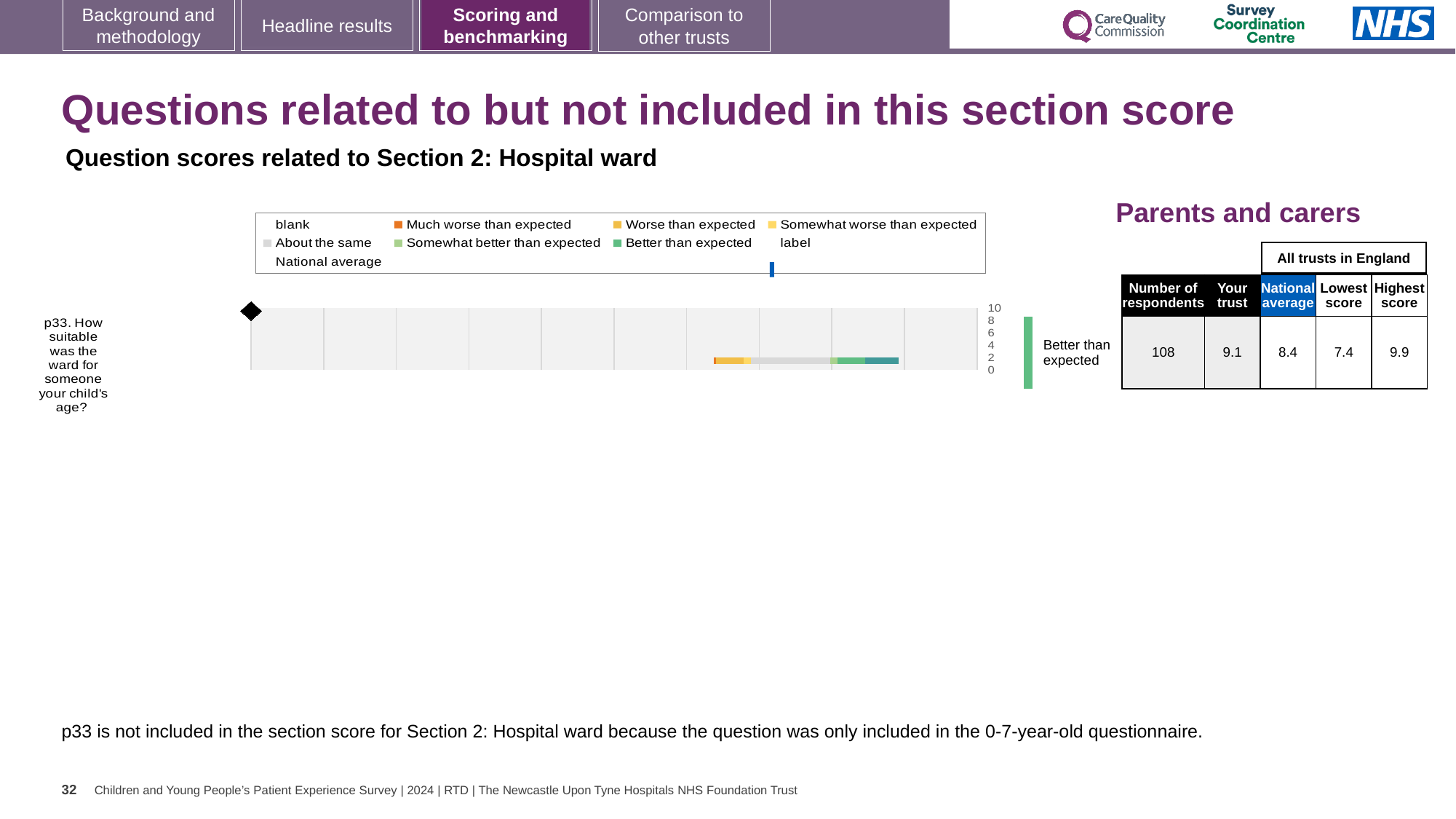
What is the highest score among all trusts in England for p33? 9.9 What is the lowest score among all trusts in England for p33? 7.4 What is the difference between the trust's score and the national average for p33? 0.7 What kind of chart is used to show the benchmarking result for question p33? bar chart What is the 'Your trust' score for p33 in the Parents and carers table? 9.1 What is the national average score for p33? 8.4 How many questions are plotted in the chart on this slide? 1 How many respondents answered p33? 108 What benchmarking category is shown next to the bar for p33? Better than expected What is the maximum value shown on the chart's score axis? 10 Which question is plotted in the chart? p33. How suitable was the ward for someone your child's age? Which is larger for p33, the trust's score or the national average? Your trust